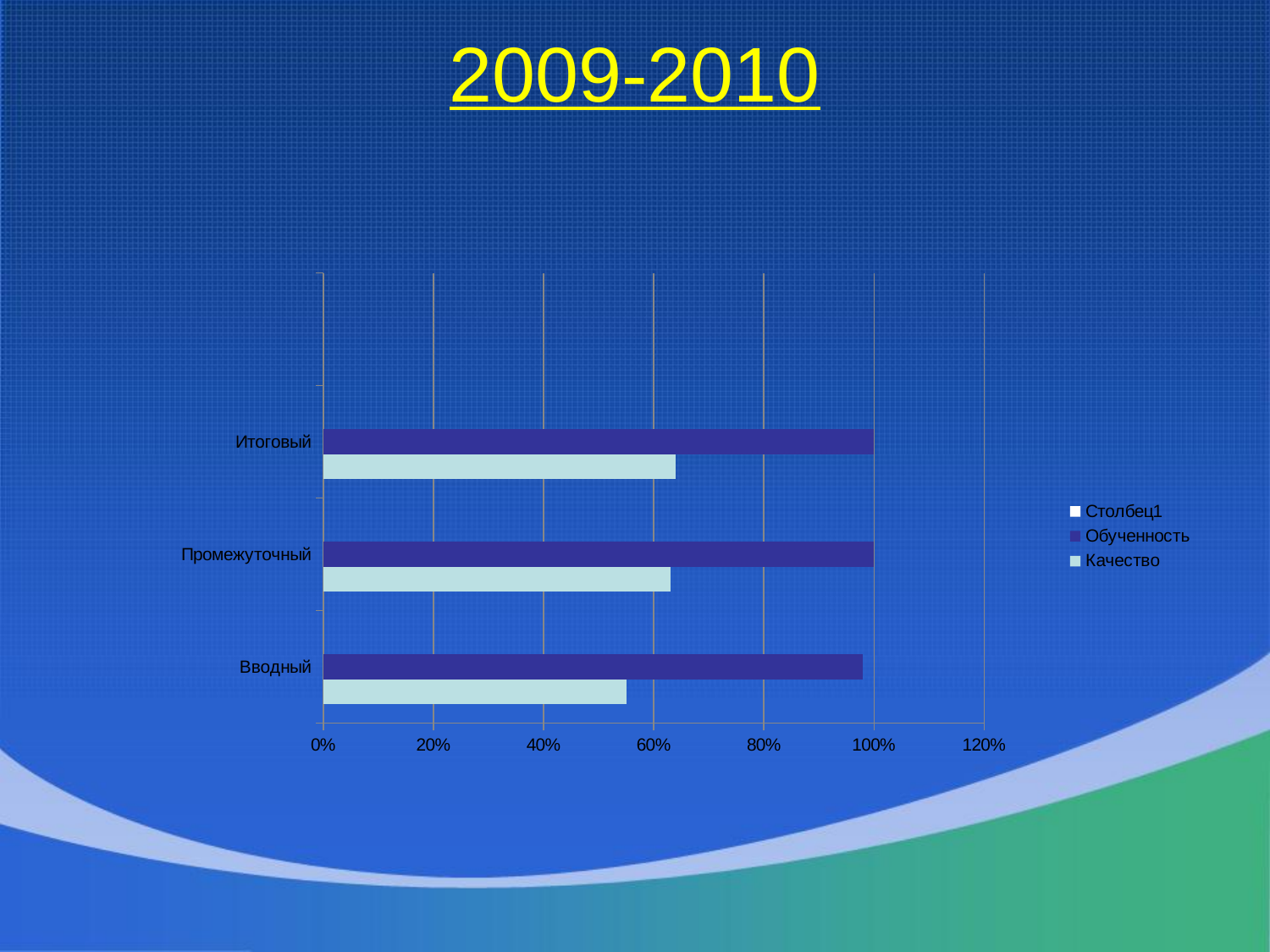
How many categories are shown on the vertical axis of the chart? 3 Is the Качество value for Вводный greater or less than 60%? less Which is larger for Итоговый: Обученность or Качество? Обученность What kind of chart is shown on the slide? bar chart What is the title shown above the chart on the slide? 2009-2010 Which category has the lowest Качество value? Вводный What are the three entries listed in the chart legend? Столбец1, Обученность, Качество Which has the larger Качество value: Итоговый or Вводный? Итоговый Is the Обученность value for Вводный greater or less than 80%? greater Is the Качество value for Промежуточный greater or less than 80%? less How many series does the chart legend list? 3